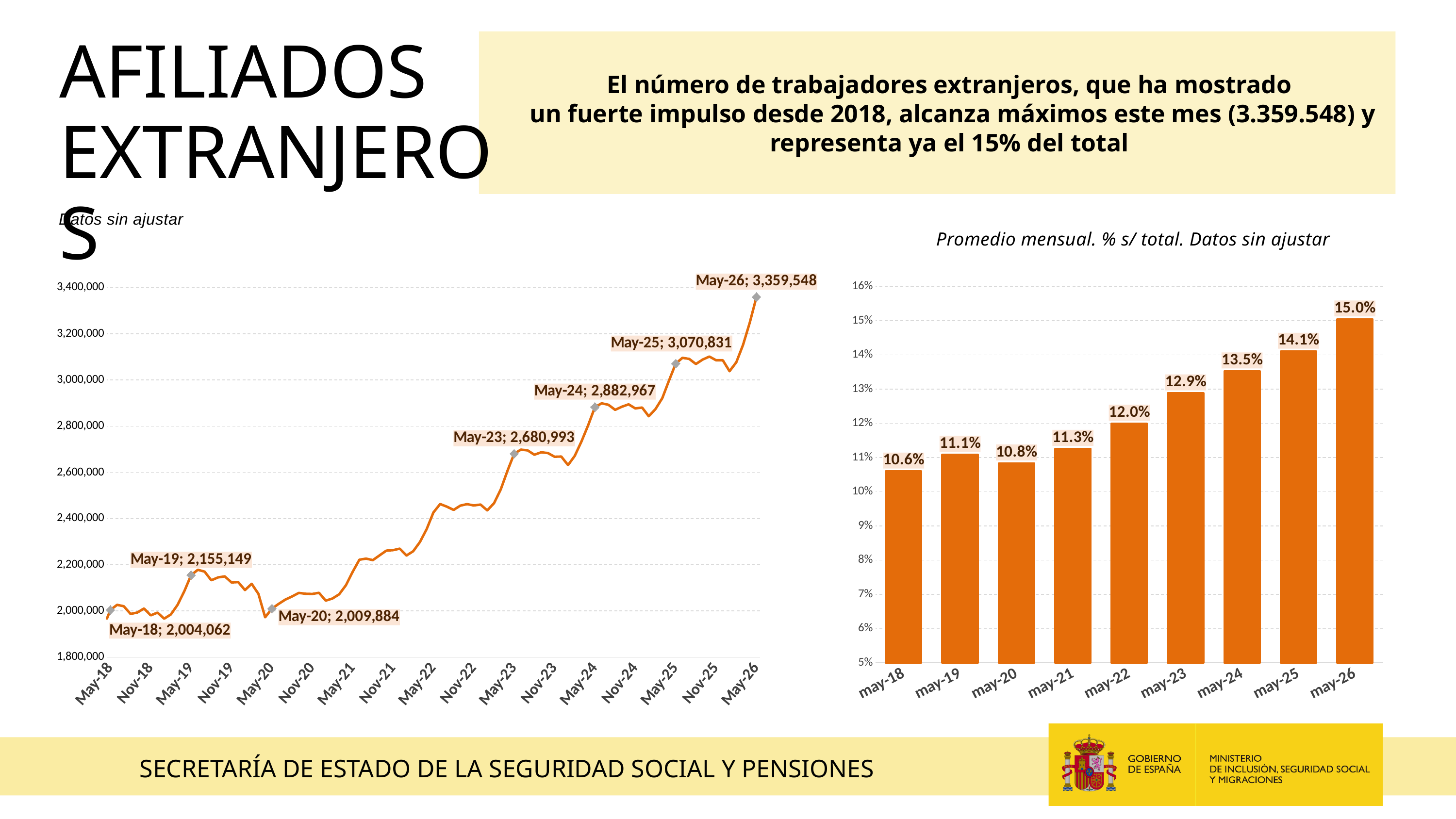
In the right bar chart, which category has the highest value? may-26 How many bars are in the right bar chart? 9 In the left line chart, which labelled point is larger, May-19 or May-20? May-19 In the left line chart, what is the value labelled for May-23? 2,680,993 In the right bar chart, what is the difference between the values for may-26 and may-18? 4.4% In the right bar chart, which category has the lowest value? may-18 What kind of chart is the chart on the left of the slide? line chart In the left line chart, what is the value labelled for May-20? 2,009,884 In the left line chart, what is the difference between the labelled values for May-25 and May-24? 187,864 In the left line chart, is the value for Nov-22 greater or less than 2,600,000? less In the left line chart, what is the value labelled for May-26? 3,359,548 In the right bar chart, what is the value for may-22? 12.0%